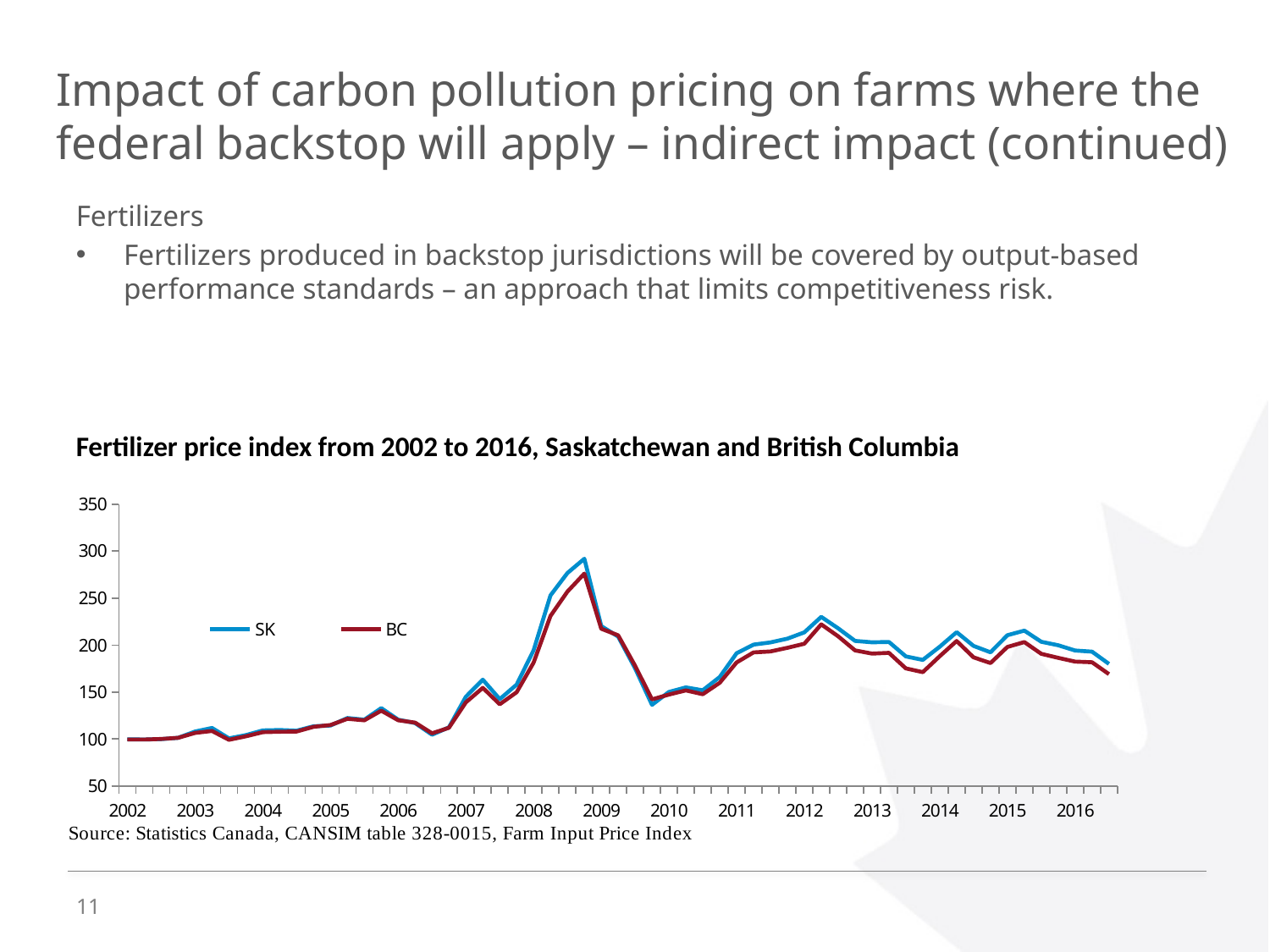
What are the two series named in the chart's legend? SK and BC Did the fertilizer price index rise or fall overall from 2002 to 2008? rise How many years are labelled along the x axis of the chart? 15 Is the peak value of the SK series greater or less than 250? greater Is the value of the BC series at the end of 2016 greater or less than 200? less What is the title of the chart? Fertilizer price index from 2002 to 2016, Saskatchewan and British Columbia Which series is higher at the end of 2016, SK or BC? SK What kind of chart is shown on the slide? line chart Is the value of the SK series at the start of 2002 greater or less than 150? less How many series does the chart's legend list? 2 Did the fertilizer price index rise or fall between 2009 and 2010? fall In which year did the SK fertilizer price index reach its highest point? 2008